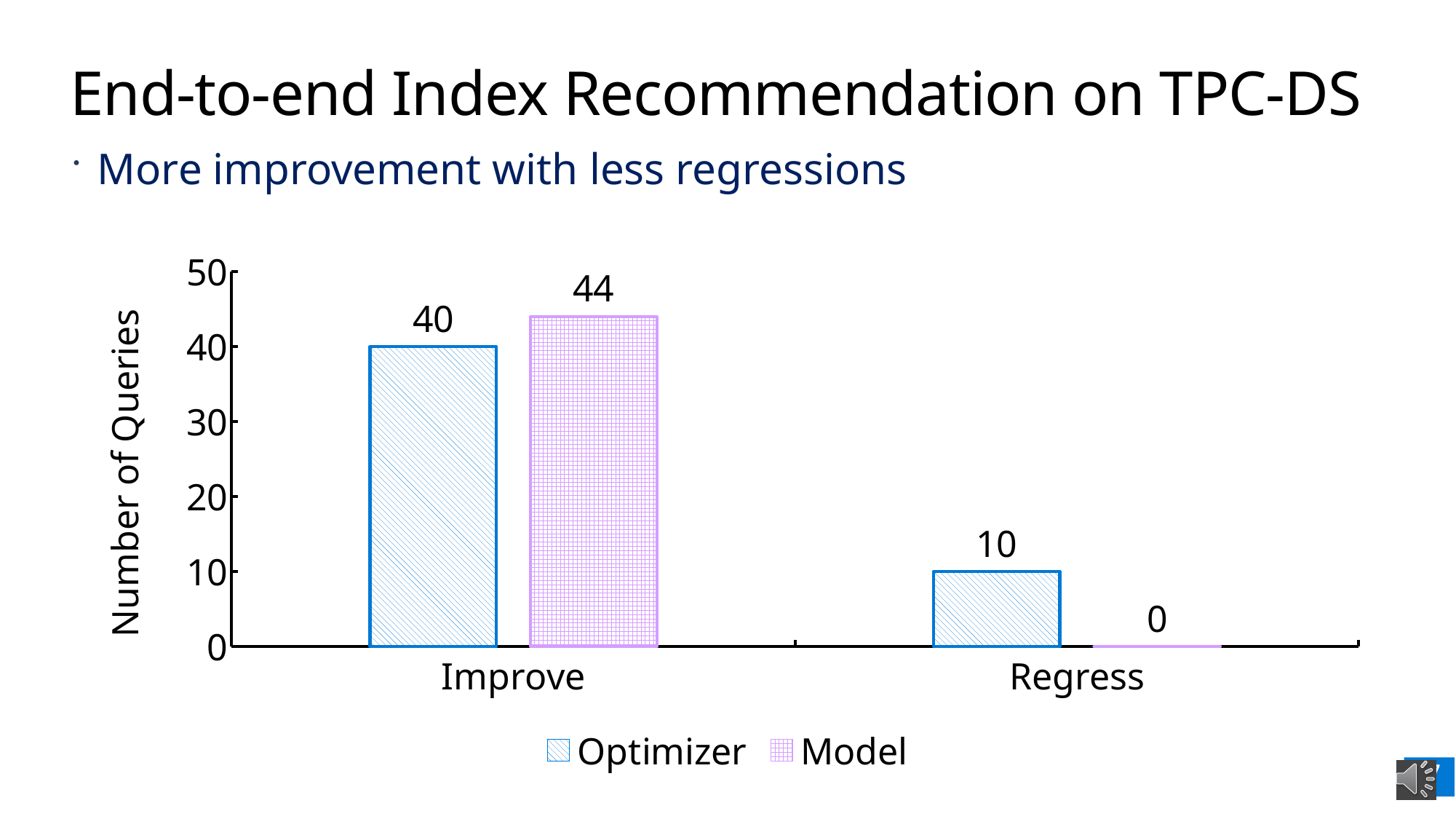
What is the number of queries for Model in the Improve category? 44 How many series does the legend list? 2 What is the number of queries for Model in the Regress category? 0 What is the difference between the Model and Optimizer values in the Improve category? 4 Which series has the lower value in the Regress category? Model What kind of chart is shown on the slide? Bar chart What is the number of queries for Optimizer in the Regress category? 10 What is the label of the y axis? Number of Queries How many categories are shown on the x axis? 2 Which series has the higher value in the Improve category? Model What is the difference between the Optimizer and Model values in the Regress category? 10 What is the number of queries for Optimizer in the Improve category? 40